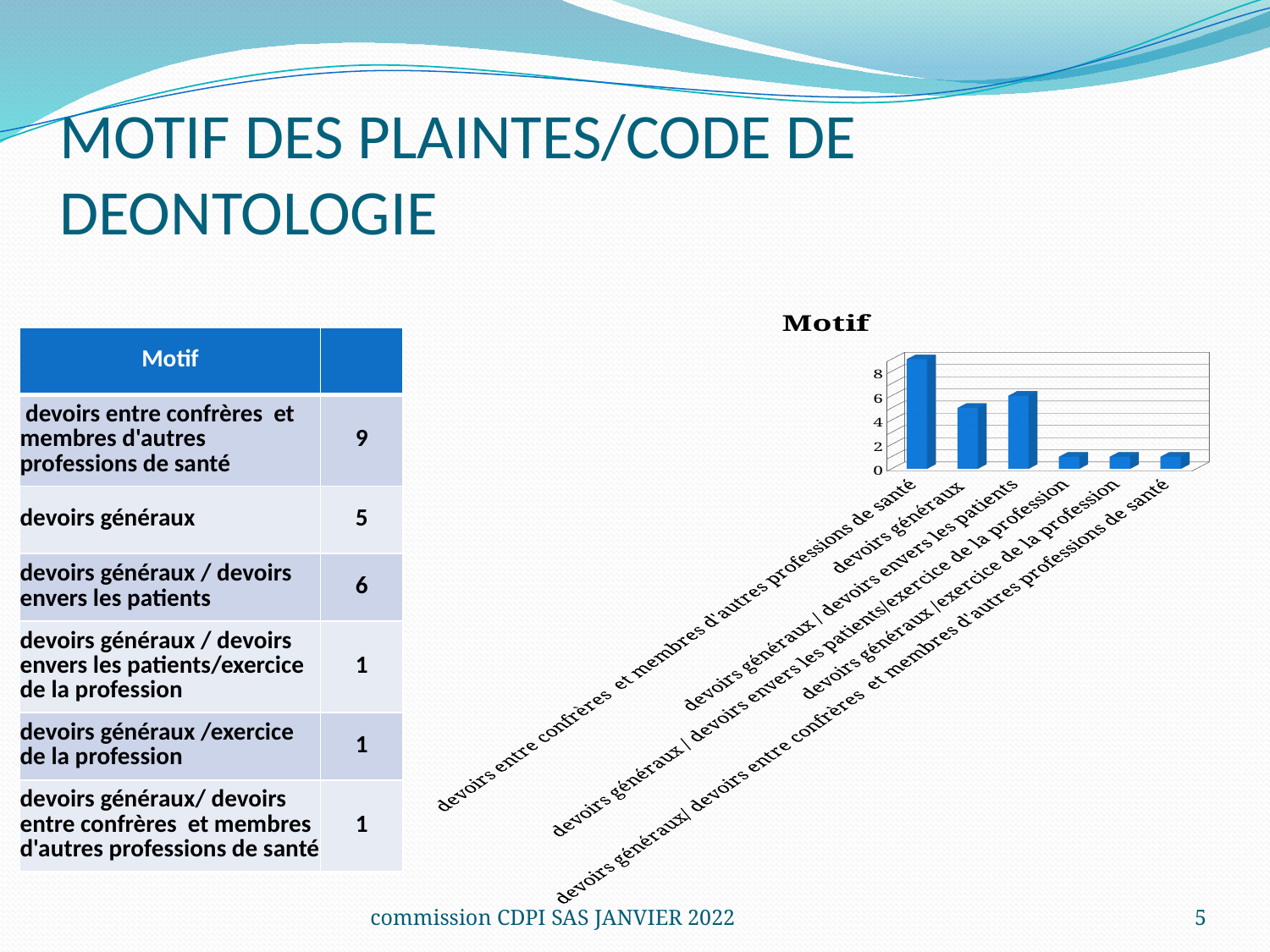
Is the value for 'devoirs entre confrères et membres d'autres professions de santé' greater or less than 6? greater Is the value for 'devoirs généraux / devoirs envers les patients/exercice de la profession' greater or less than 2? less What is the value for 'devoirs généraux / devoirs envers les patients'? 6 What kind of chart is shown on the slide? bar chart Which is larger: the value for 'devoirs généraux' or the value for 'devoirs généraux / devoirs envers les patients'? devoirs généraux / devoirs envers les patients What is the value for 'devoirs généraux'? 5 What is the title of the chart? Motif What is the value for 'devoirs généraux /exercice de la profession'? 1 What is the difference between the value for 'devoirs entre confrères et membres d'autres professions de santé' and the value for 'devoirs généraux'? 4 How many categories are plotted in the chart? 6 Which category has the highest bar in the chart? devoirs entre confrères et membres d'autres professions de santé What is the value for 'devoirs entre confrères et membres d'autres professions de santé'? 9